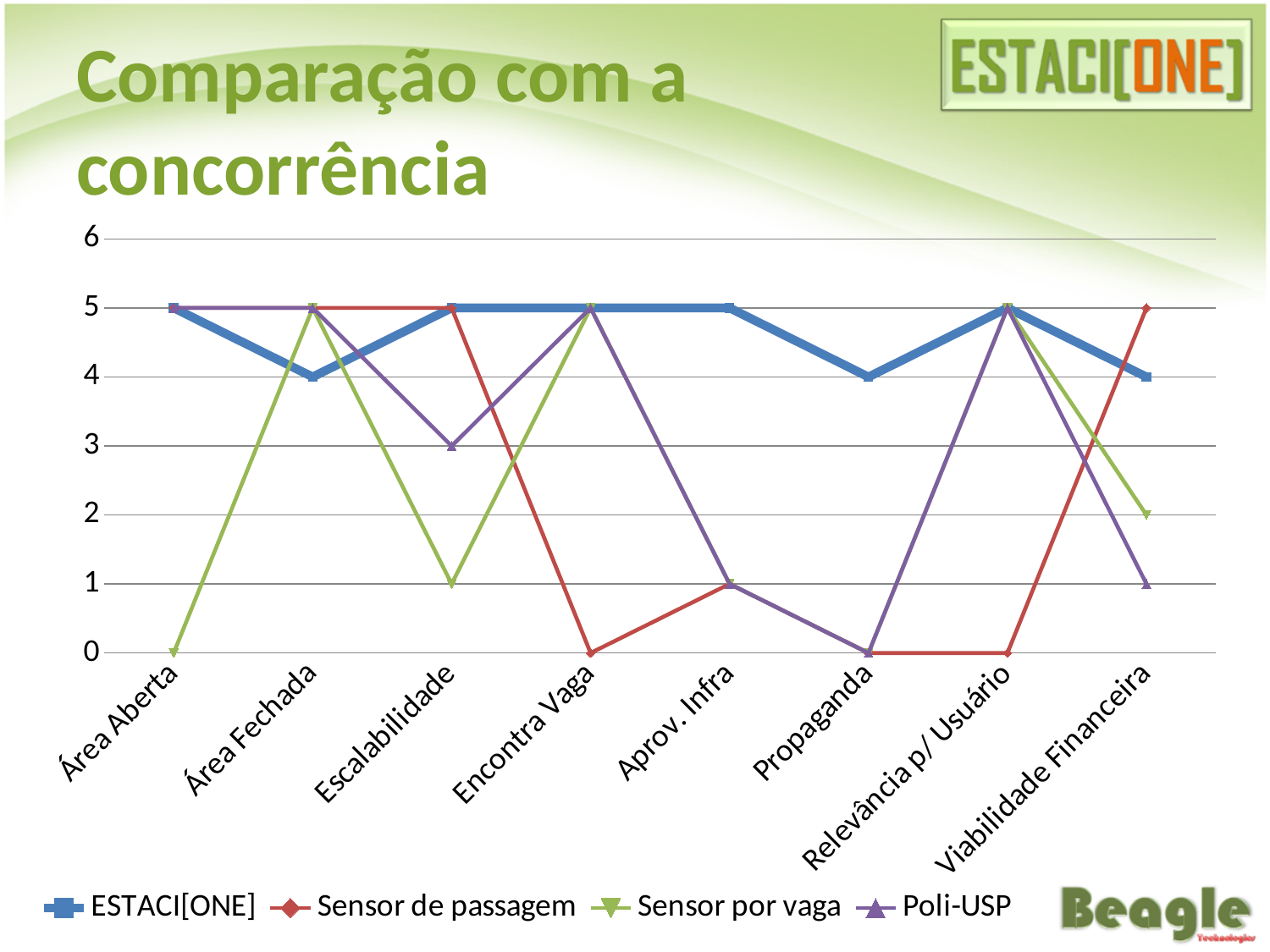
What is the value for Sensor de passagem at Encontra Vaga? 0 Which series has the lowest value at Área Aberta? Sensor por vaga What is the title of the slide containing the chart? Comparação com a concorrência Which series has the highest value at Propaganda? ESTACI[ONE] What is the value for Poli-USP at Escalabilidade? 3 What is the value for Sensor por vaga at Viabilidade Financeira? 2 How many categories are shown on the x axis? 8 What kind of chart is shown on the slide? line chart What is the difference between ESTACI[ONE] and Sensor por vaga at Escalabilidade? 4 What is the value for ESTACI[ONE] at Propaganda? 4 At Viabilidade Financeira, which is larger: Sensor de passagem or Poli-USP? Sensor de passagem How many series does the legend list? 4